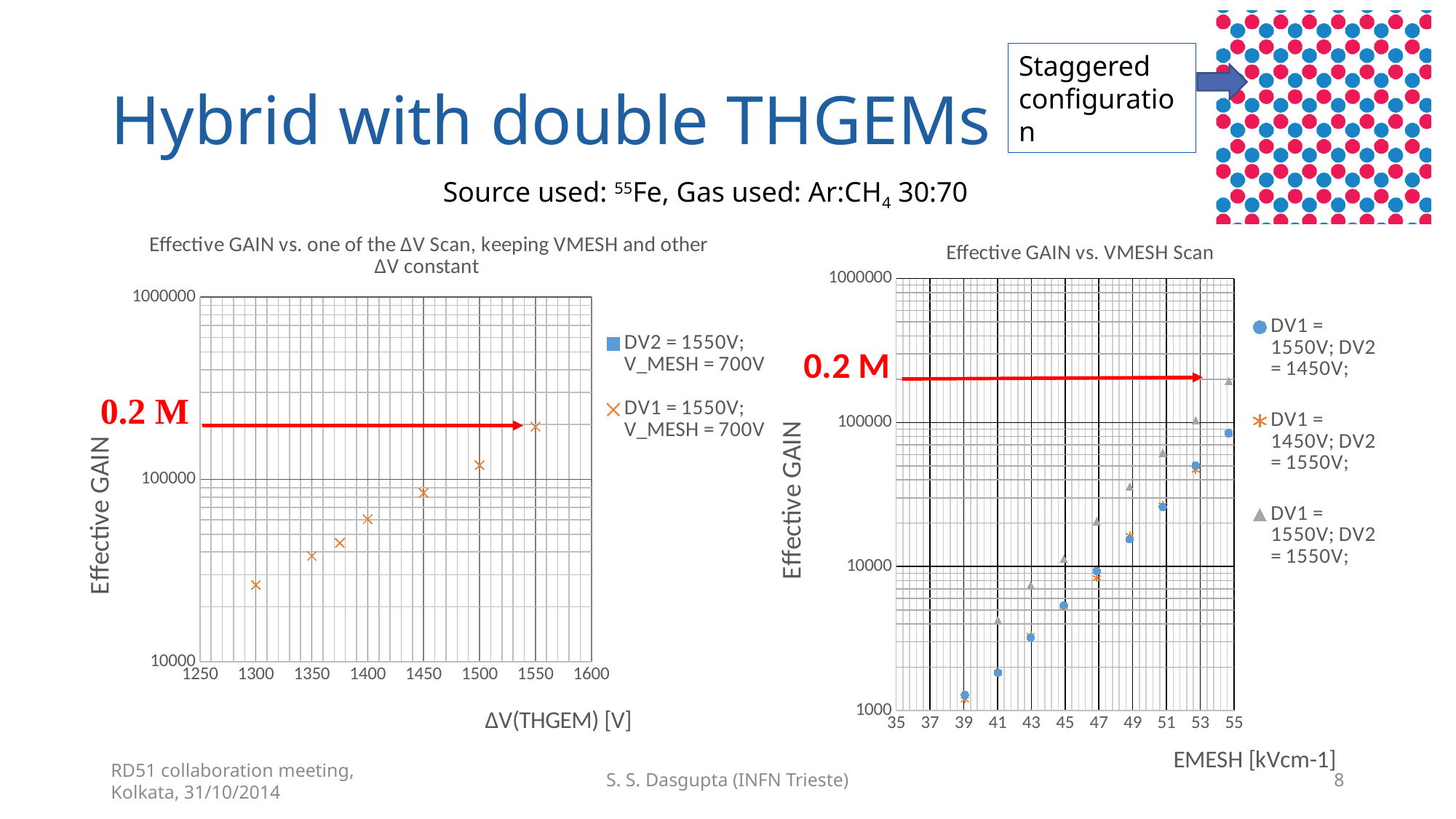
In the right chart, 'Effective GAIN vs. VMESH Scan', is the value at EMESH = 45 for the 'DV1 = 1550V; DV2 = 1450V' series greater or less than 10000? less In the right chart, 'Effective GAIN vs. VMESH Scan', is the value at EMESH = 55 for the 'DV1 = 1550V; DV2 = 1550V' series greater or less than 100000? greater In the left chart, 'Effective GAIN vs. one of the ΔV Scan', how many data points are plotted? 7 How many series does the legend of the left chart, 'Effective GAIN vs. one of the ΔV Scan', list? 2 What is the x-axis label of the right chart, 'Effective GAIN vs. VMESH Scan'? EMESH [kVcm-1] In the left chart, 'Effective GAIN vs. one of the ΔV Scan', is the value at ΔV(THGEM) = 1550 greater or less than 100000? greater What kind of chart is the left chart, 'Effective GAIN vs. one of the ΔV Scan, keeping VMESH and other ΔV constant'? scatter chart In the left chart, 'Effective GAIN vs. one of the ΔV Scan', do the plotted values rise or fall as ΔV(THGEM) increases? rise How many series does the legend of the right chart, 'Effective GAIN vs. VMESH Scan', list? 3 In the left chart, 'Effective GAIN vs. one of the ΔV Scan', which is larger: the value at ΔV(THGEM) = 1500 or at 1400? 1500 In the right chart, 'Effective GAIN vs. VMESH Scan', do the plotted values rise or fall as EMESH increases? rise